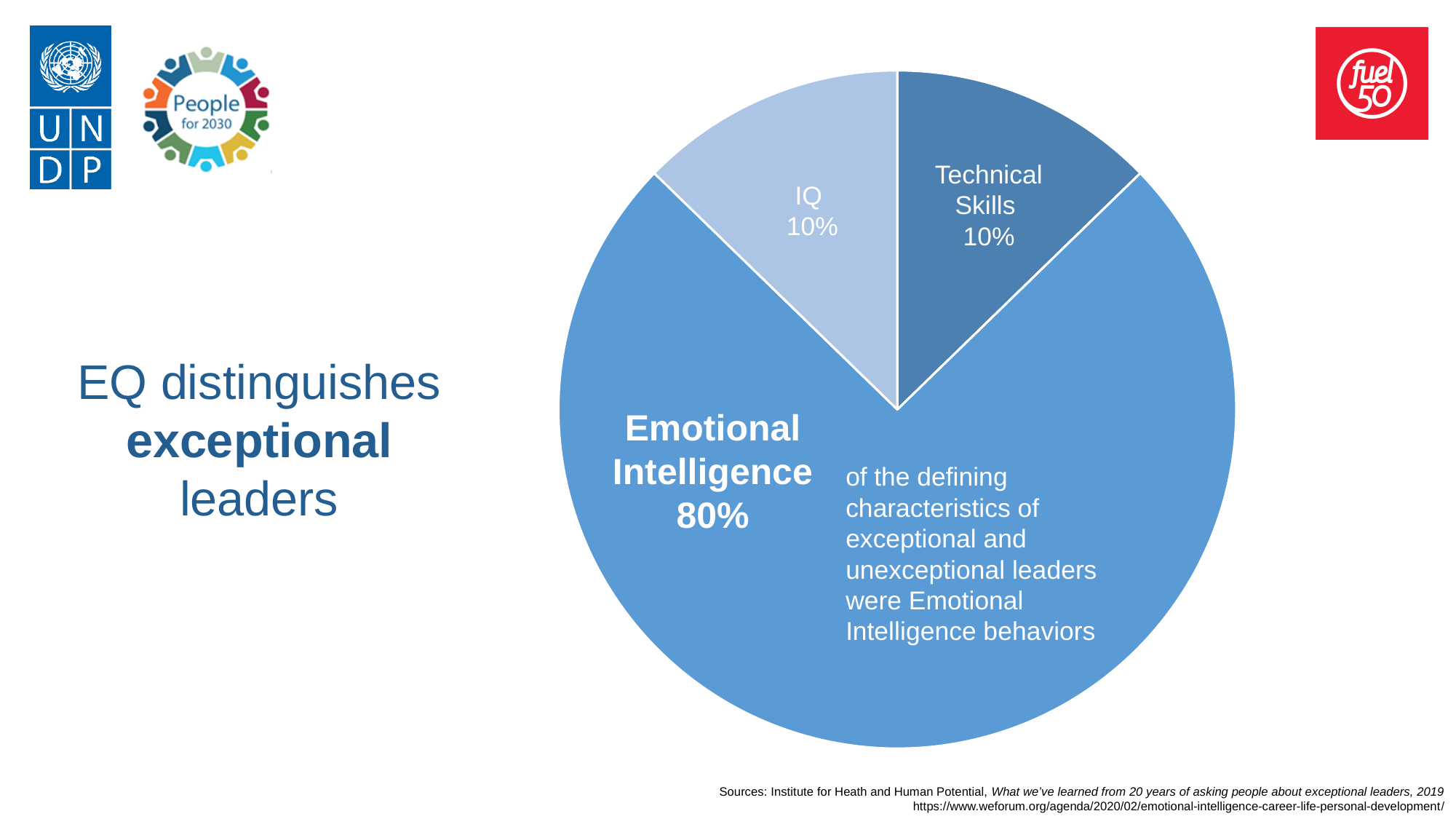
Which slice of the pie is the lightest in colour? IQ What kind of chart is shown on the slide? Pie chart What is the title text shown to the left of the pie chart? EQ distinguishes exceptional leaders Is the share for Emotional Intelligence greater or less than 50%? greater Which slice of the pie is the largest? Emotional Intelligence Which is larger, the Emotional Intelligence slice or the Technical Skills slice? Emotional Intelligence What is the value shown for IQ? 10% What is the value shown for Technical Skills? 10% What is the combined share of IQ and Technical Skills? 20% What share of the pie does Emotional Intelligence represent? 80% How many slices does the pie chart have? 3 What is the difference between the Emotional Intelligence share and the IQ share? 70%